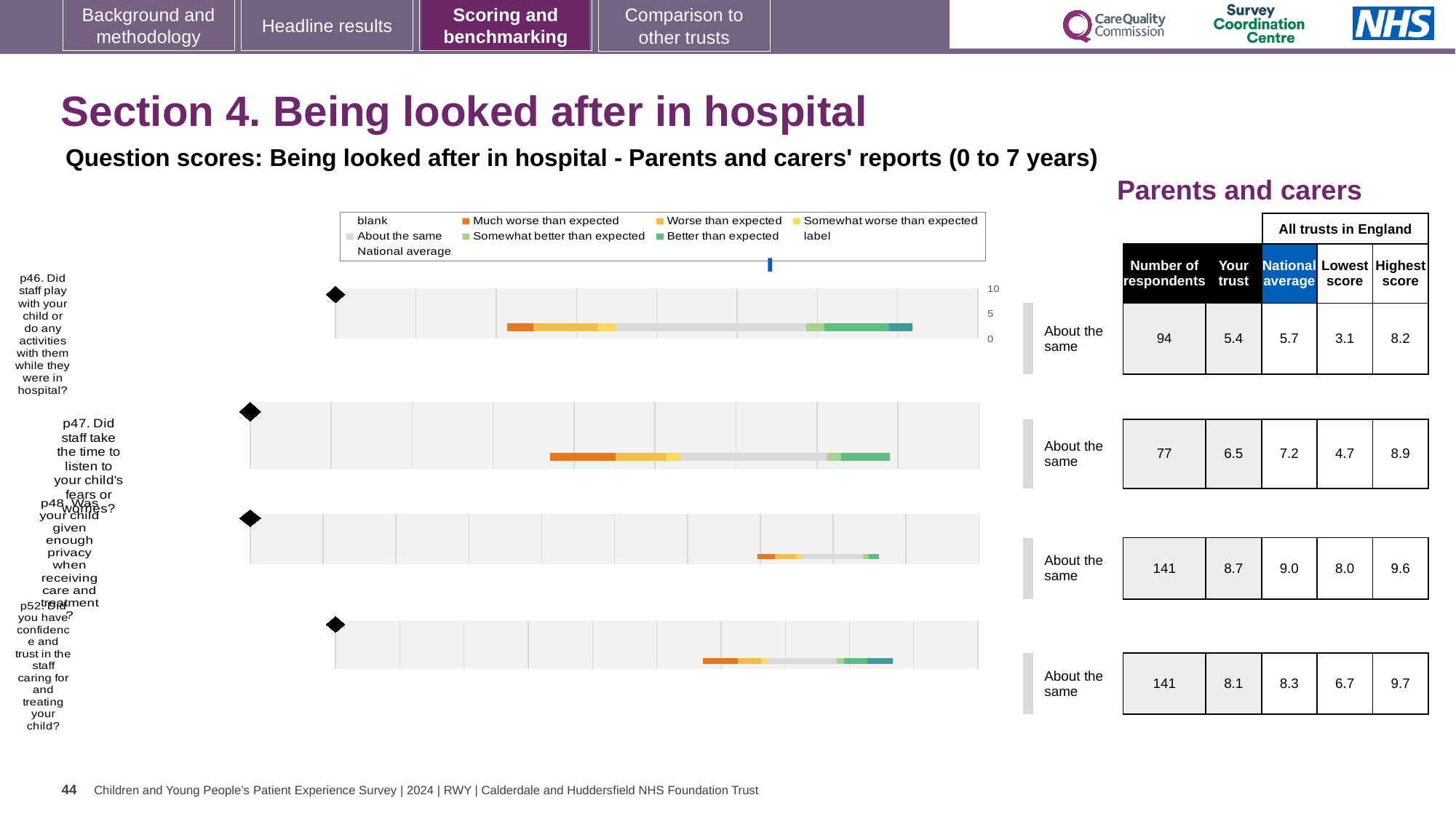
Which question has the lowest 'Your trust' score? p46 What is the highest score across all trusts in England for p52 (Did you have confidence and trust in the staff caring for and treating your child?)? 9.7 What is the 'Your trust' score for p46 (Did staff play with your child or do any activities with them while they were in hospital?)? 5.4 What colour does the legend use for 'Much worse than expected'? Orange What is the difference between the highest score (8.2) and the lowest score (3.1) for p46? 5.1 For p52, which is larger: the 'Your trust' score or the national average? National average What kind of chart is used to show the question scores on this slide? bar chart What is the national average score for p47 (Did staff take the time to listen to your child's fears or worries?)? 7.2 Which question has the highest 'Your trust' score? p48 How many survey questions (bars) are shown in the chart area? 4 What benchmark category is shown next to each of the four question bars? About the same How many respondents are listed for p48 (Was your child given enough privacy when receiving care and treatment?)? 141